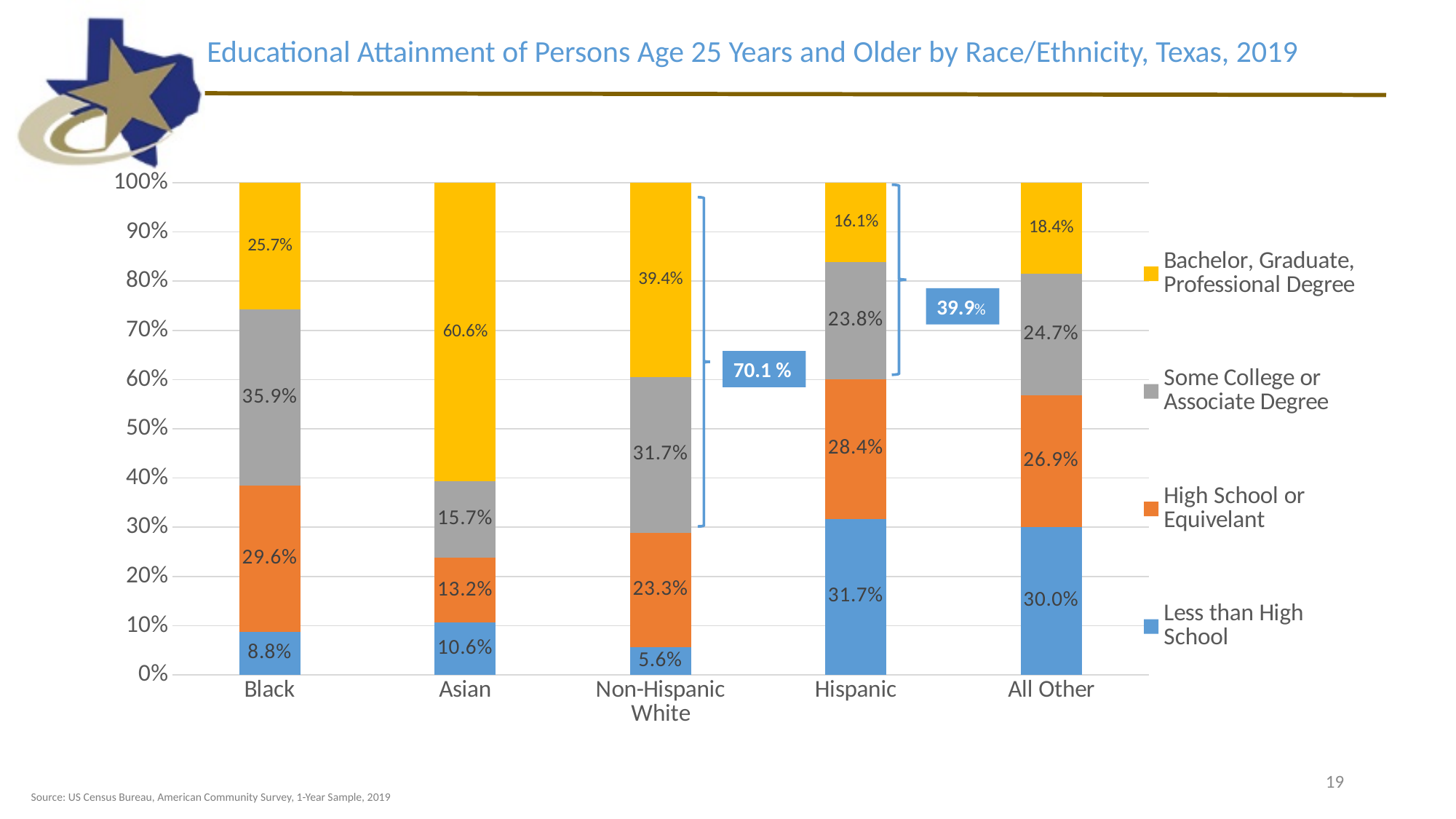
What is the combined share of Some College or Associate Degree and Bachelor, Graduate, Professional Degree for Hispanic persons? 39.9% How many percentage points higher is the Bachelor, Graduate, Professional Degree share for Asian persons than for Black persons? 34.9 percentage points What is the High School or Equivalent value for Asian persons? 13.2% What kind of chart is shown on the slide? Stacked bar chart What is the Less than High School value for Hispanic persons? 31.7% What is the Some College or Associate Degree value for the All Other group? 24.7% Which is larger: the High School or Equivalent share for Black persons or for Hispanic persons? Black Which race/ethnicity group has the highest share with a Bachelor, Graduate, or Professional Degree? Asian What percentage of Black persons age 25 and older have a Bachelor, Graduate, or Professional Degree? 25.7% Which race/ethnicity group has the lowest Less than High School share? Non-Hispanic White How many series does the legend list? 4 How many race/ethnicity categories are shown on the x axis? 5